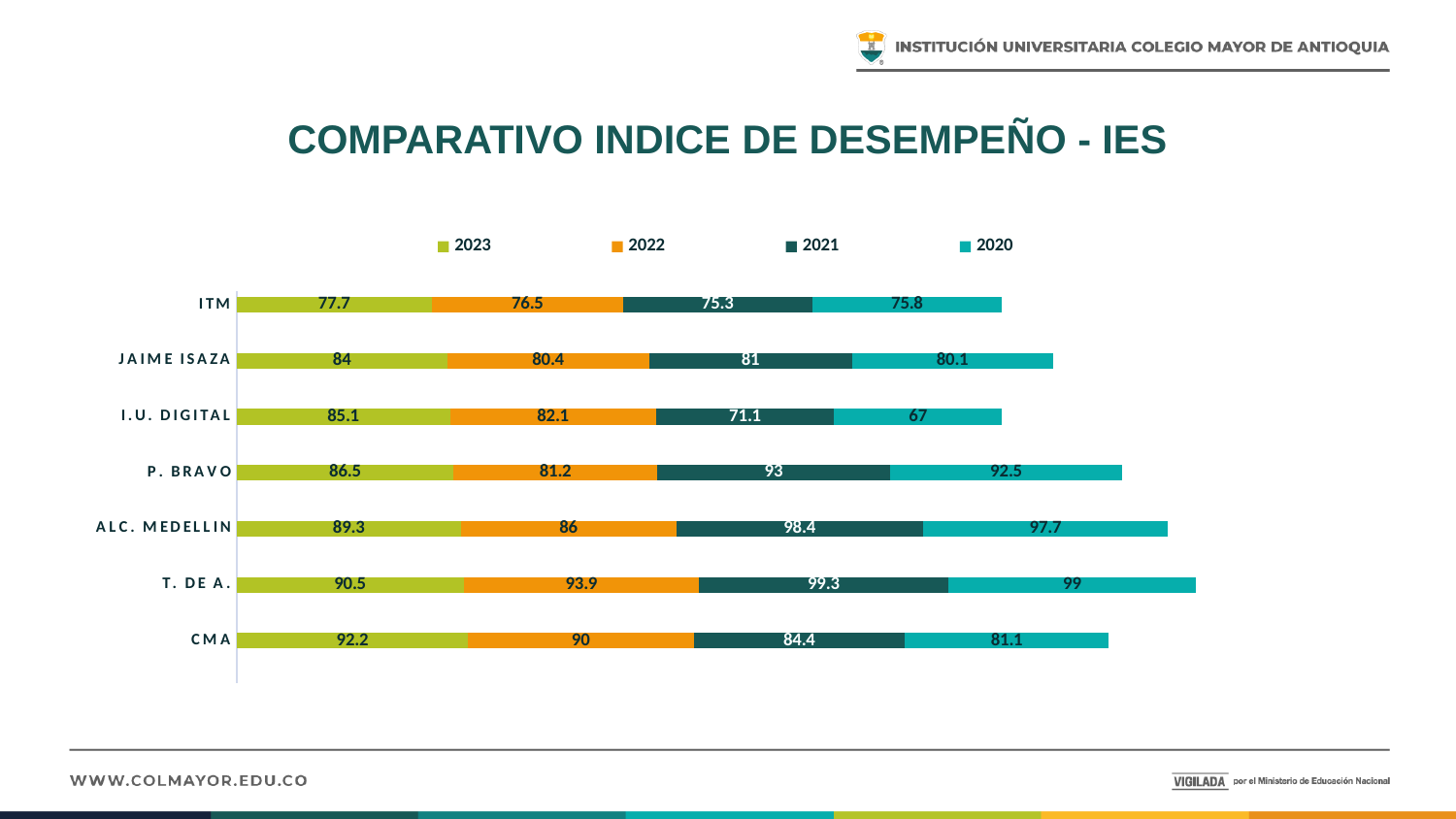
What is the value for CMA in 2023? 92.2 Which is larger for P. BRAVO: the 2021 value or the 2023 value? 2021 Which institution has the highest value for 2023? CMA What is the value for ALC. MEDELLIN in 2021? 98.4 What is the value for I.U. DIGITAL in 2020? 67 Which institution has the lowest value for 2020? I.U. DIGITAL How many series does the legend list? 4 How many institutions are shown in the chart? 7 What type of chart is shown on the slide? Stacked bar chart Which institution has the lowest value for 2023? ITM What is the difference between the 2023 and 2020 values for CMA? 11.1 What is the total of the stacked bar for T. DE A.? 382.7